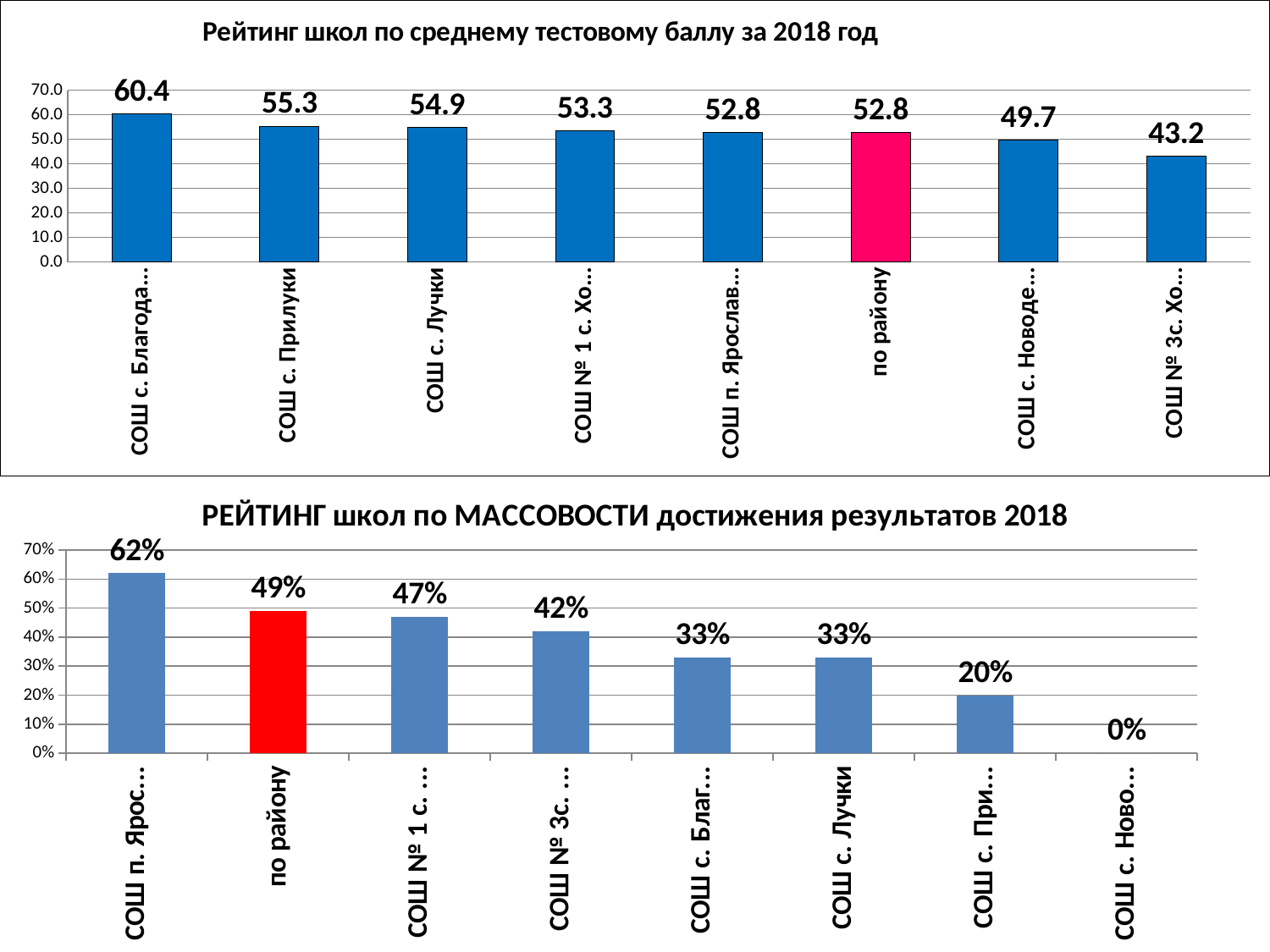
In the top chart (Рейтинг школ по среднему тестовому баллу за 2018 год), what is the value for по району? 52.8 In the bottom chart (РЕЙТИНГ школ по МАССОВОСТИ достижения результатов 2018), which is larger: the value for по району or the value for СОШ с. Лучки? по району In the bottom chart (РЕЙТИНГ школ по МАССОВОСТИ достижения результатов 2018), what is the value for по району? 49% In the top chart (Рейтинг школ по среднему тестовому баллу за 2018 год), what is the value for СОШ с. Прилуки? 55.3 In the top chart (Рейтинг школ по среднему тестовому баллу за 2018 год), what is the lowest value shown? 43.2 In the bottom chart (РЕЙТИНГ школ по МАССОВОСТИ достижения результатов 2018), what is the value for СОШ с. Лучки? 33% In the top chart (Рейтинг школ по среднему тестовому баллу за 2018 год), what is the value for СОШ с. Лучки? 54.9 What kind of chart is the bottom chart (РЕЙТИНГ школ по МАССОВОСТИ достижения результатов 2018)? Bar chart In the top chart (Рейтинг школ по среднему тестовому баллу за 2018 год), how many bars are there? 8 In the top chart (Рейтинг школ по среднему тестовому баллу за 2018 год), what is the highest value shown? 60.4 In the top chart (Рейтинг школ по среднему тестовому баллу за 2018 год), what is the difference between the values for СОШ с. Прилуки and СОШ с. Лучки? 0.4 In the bottom chart (РЕЙТИНГ школ по МАССОВОСТИ достижения результатов 2018), what is the highest value shown? 62%